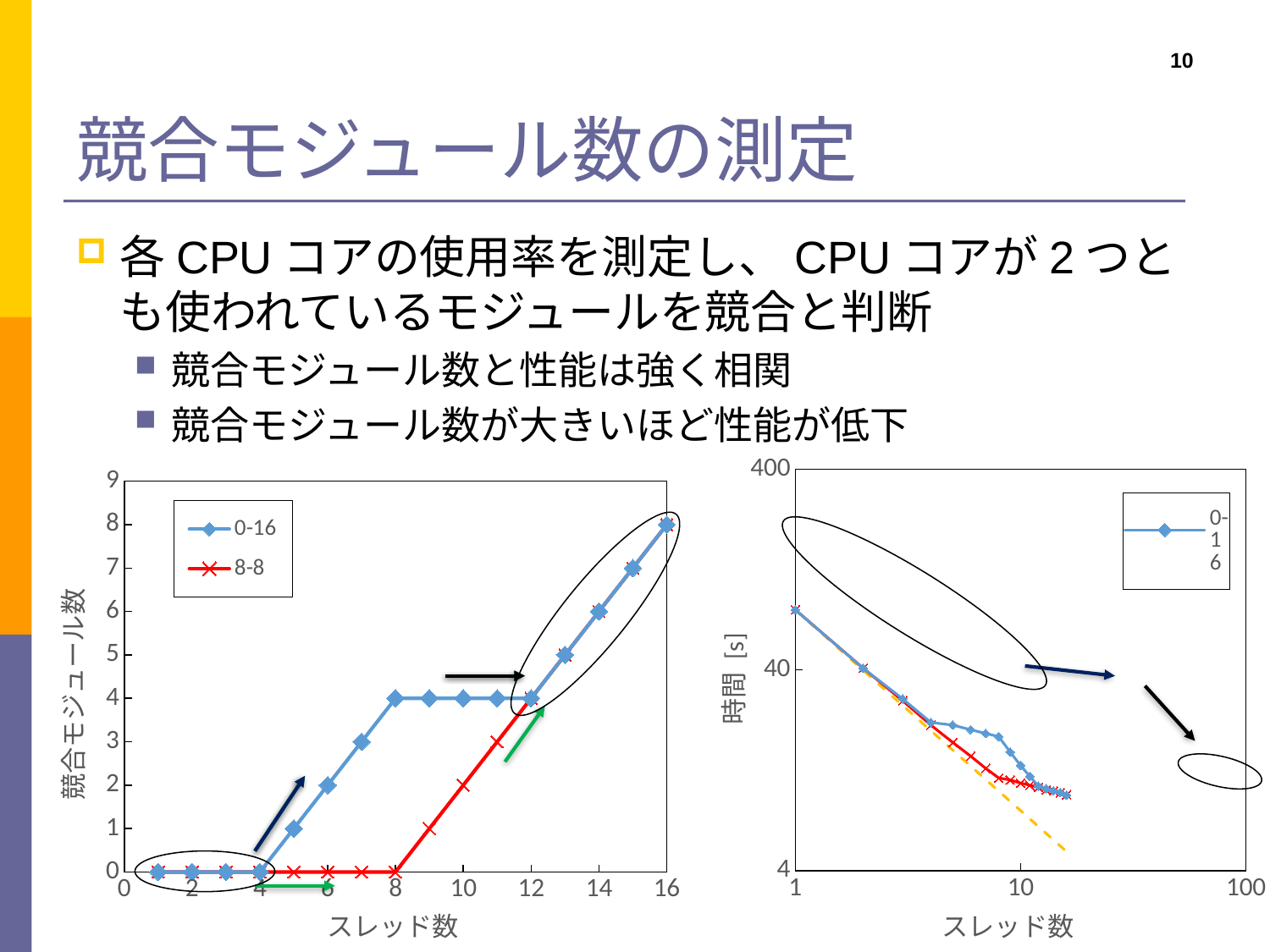
In the left chart, at which thread count does the 0-16 series reach its highest value? 16 In the left chart, what is the value of the 8-8 series at 8 threads? 0 What kind of chart is the left chart (競合モジュール数 vs スレッド数)? line chart In the left chart, what is the value of the 8-8 series at 10 threads? 2 What is the y-axis label of the right chart? 時間 [s] In the left chart, what is the difference between the 0-16 and 8-8 series at 8 threads? 4 In the right chart, is the time at 1 thread greater or less than 40? greater In the left chart, what is the value of the 0-16 series at 16 threads? 8 How many series does the legend of the left chart list? 2 In the left chart, what is the value of the 0-16 series at 8 threads? 4 In the left chart, at 6 threads, which series has the larger value, 0-16 or 8-8? 0-16 In the right chart (時間 [s] vs スレッド数), do the values rise or fall as the number of threads increases? fall